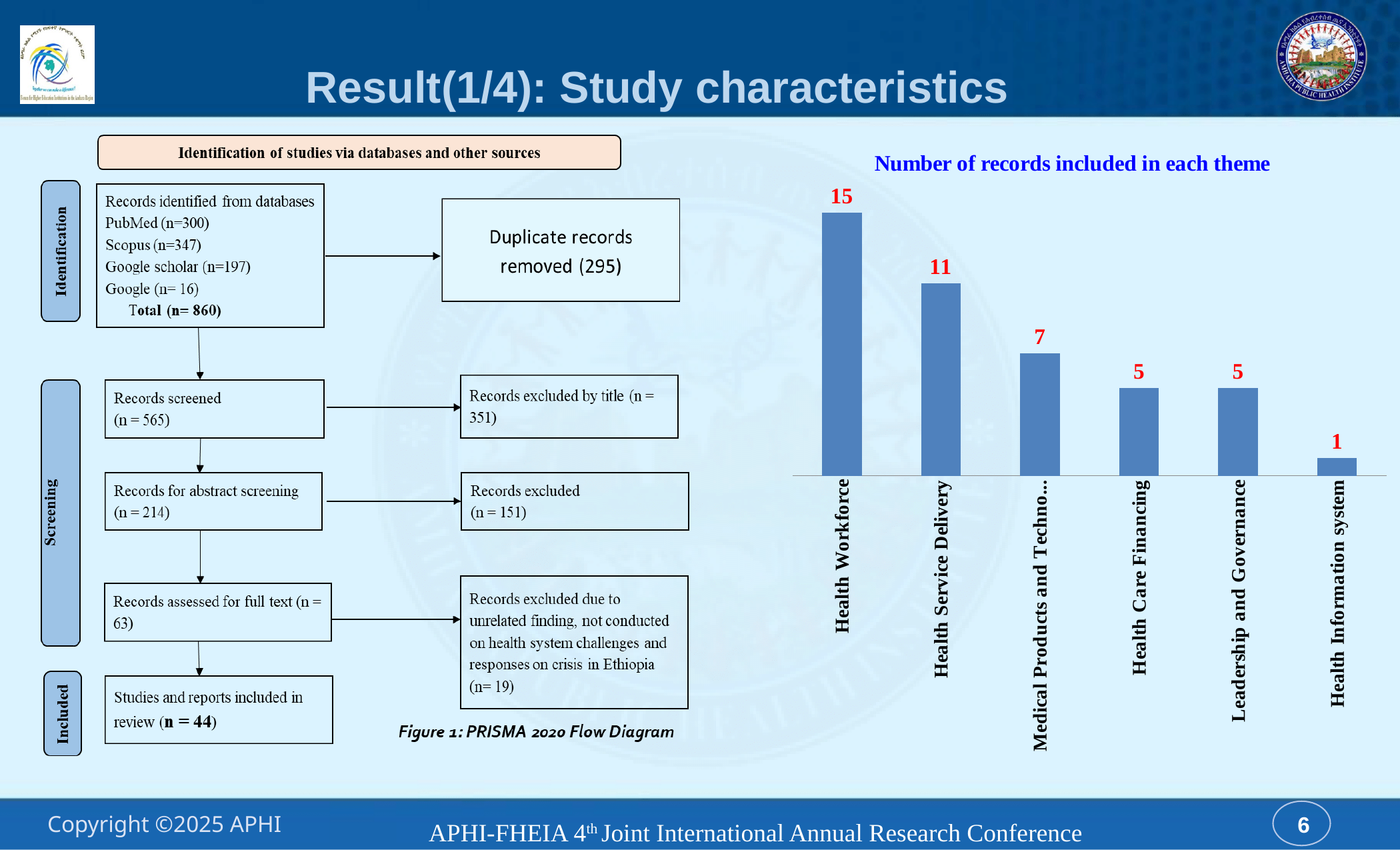
Which theme has more records included, Health Service Delivery or Leadership and Governance? Health Service Delivery Do the values rise or fall from left to right across the chart? fall How many records are included for the Health Information system theme? 1 Which theme has the highest number of records included? Health Workforce What type of chart is shown on the slide? bar chart How many themes are shown in the chart? 6 How many records are included for the Health Care Financing theme? 5 What is the difference in the number of records between Health Workforce and Health Service Delivery? 4 How many records are included for the Health Service Delivery theme? 11 Which theme has the lowest number of records included? Health Information system How many records are included for the Health Workforce theme? 15 What is the title of the chart? Number of records included in each theme